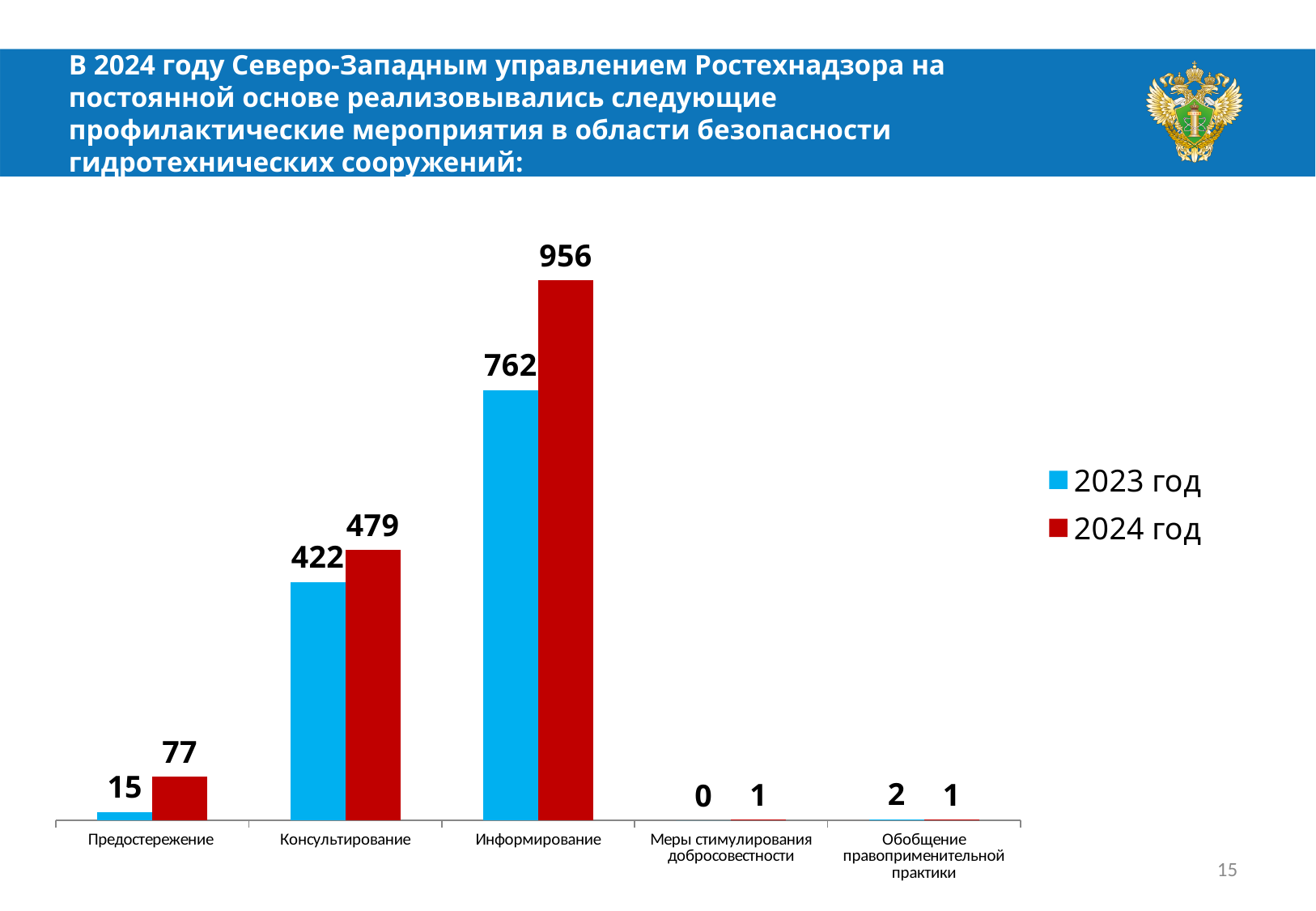
Which category has the lowest value for 2023 год? Меры стимулирования добросовестности What is the difference between the 2024 год and 2023 год values for Предостережение? 62 Which is larger for Обобщение правоприменительной практики: the 2023 год value or the 2024 год value? 2023 год What is the value for Предостережение in 2023 год? 15 How many series does the legend list? 2 What is the value for Информирование in 2024 год? 956 What is the difference between the 2024 год and 2023 год values for Информирование? 194 What is the value for Меры стимулирования добросовестности in 2023 год? 0 What kind of chart is shown on the slide? Bar chart Which category has the highest value for 2024 год? Информирование What is the value for Консультирование in 2024 год? 479 How many categories are shown on the x axis? 5